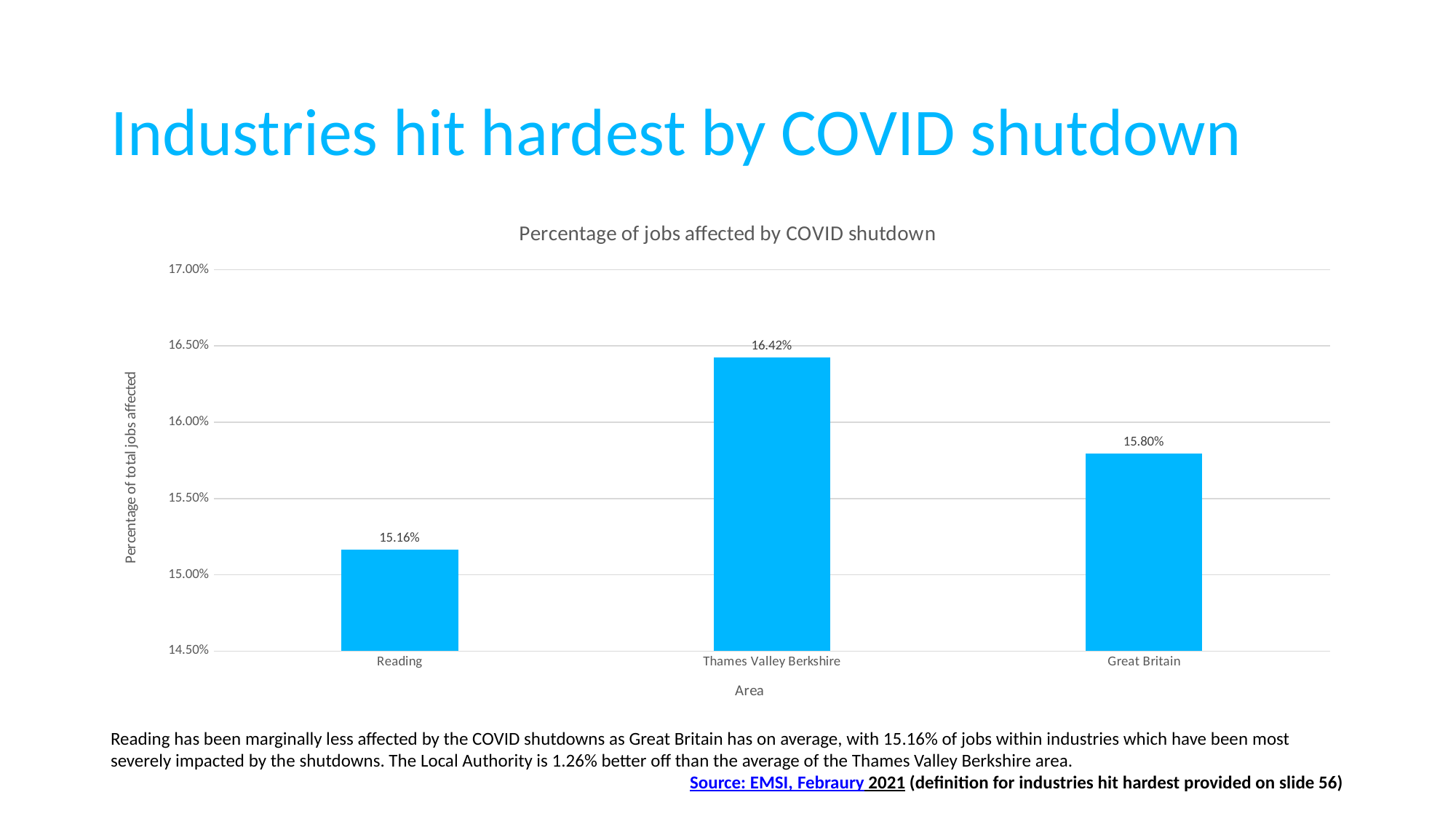
Which area has the highest percentage of jobs affected by COVID shutdown? Thames Valley Berkshire What is the percentage of jobs affected by COVID shutdown for Great Britain? 15.80% How many areas are shown on the chart? 3 What is the title of the chart? Percentage of jobs affected by COVID shutdown What is the percentage of jobs affected by COVID shutdown for Reading? 15.16% What is the difference in percentage points between Thames Valley Berkshire and Reading? 1.26% Which area has the lowest percentage of jobs affected by COVID shutdown? Reading What type of chart is shown on the slide? Bar chart What is the difference in percentage points between Great Britain and Reading? 0.64% Which has a higher percentage of jobs affected, Great Britain or Reading? Great Britain What is the percentage of jobs affected by COVID shutdown for Thames Valley Berkshire? 16.42% Is the value for Thames Valley Berkshire greater or less than 16.00%? greater